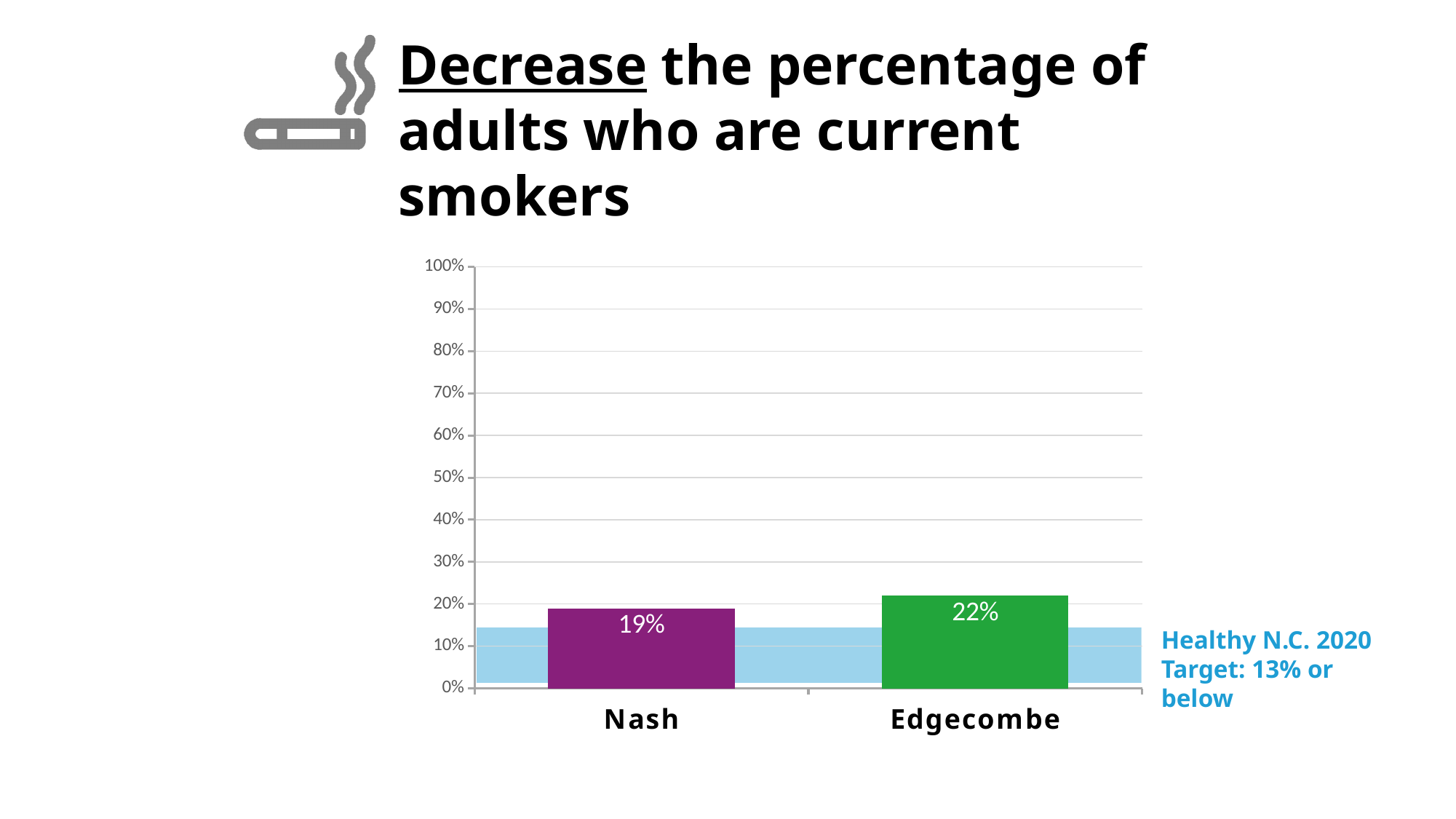
What is the percentage of adults who are current smokers in Edgecombe? 22% What is the Healthy N.C. 2020 target shown on the chart? 13% or below Is the value for Nash greater or less than 20%? less How many counties are shown in the chart? 2 Which county has the higher percentage of adults who are current smokers? Edgecombe Is the value for Nash greater or less than the 13% target? greater Is the value for Edgecombe greater or less than 20%? greater Which county has the lower percentage of adults who are current smokers? Nash What is the maximum value shown on the vertical axis? 100% What kind of chart is shown on the slide? Bar chart What is the difference in percentage points between Edgecombe and Nash? 3% What is the percentage of adults who are current smokers in Nash? 19%